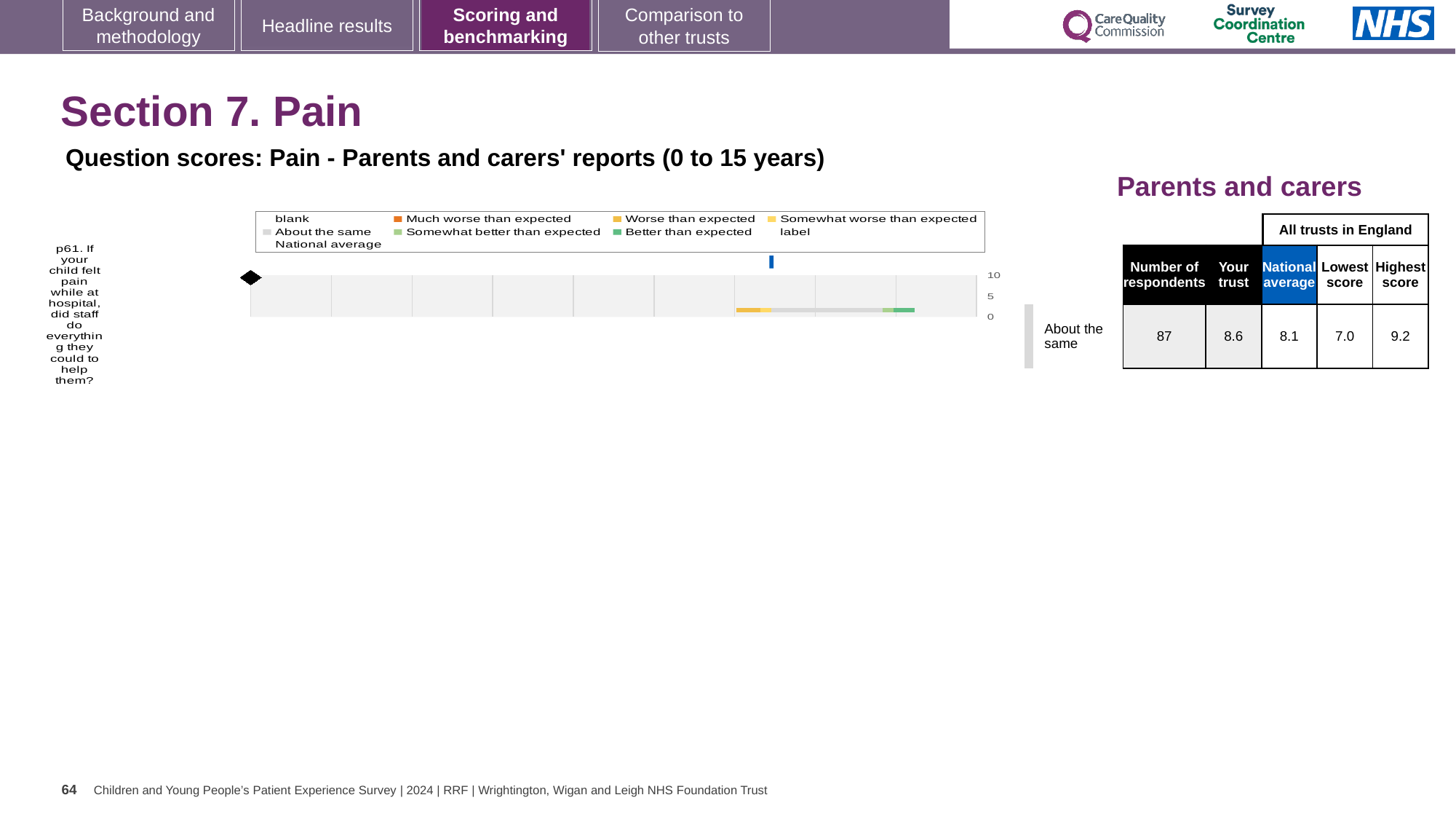
What kind of chart is shown on the slide? bar chart How is the trust's result for question p61 categorised relative to expectation? About the same According to the table, how many respondents answered question p61? 87 Which is larger for question p61: the 'Your trust' score or the national average? Your trust According to the table, what is the highest score among all trusts in England for question p61? 9.2 How many entries does the chart legend list? 9 How many survey questions are plotted in the chart? 1 According to the table, what is the lowest score among all trusts in England for question p61? 7.0 According to the table, what is the 'Your trust' score for question p61? 8.6 What is the difference between the 'Your trust' score and the national average for question p61? 0.5 What is the highest value shown on the chart's axis? 10 According to the table, what is the national average score for question p61? 8.1